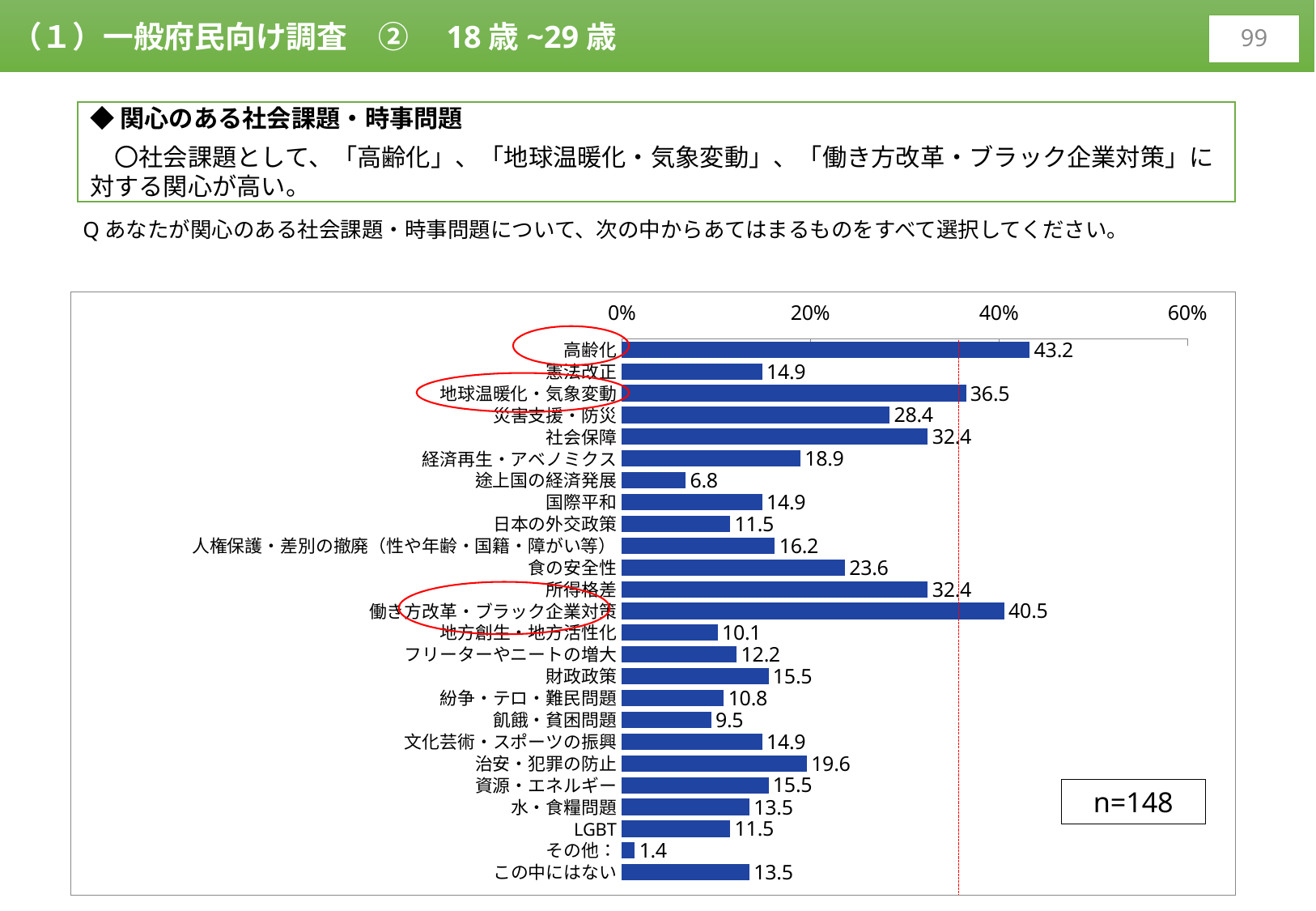
What is the value for 治安・犯罪の防止? 19.6 Is the value for 社会保障 greater or less than 20%? greater How many categories are shown in the chart? 25 What is the value for 働き方改革・ブラック企業対策? 40.5 What is the difference between the values for 高齢化 and 地球温暖化・気象変動? 6.7 Which category has the highest value? 高齢化 What is the value for 高齢化? 43.2 Which category has the lowest value? その他： What is the sample size (n) shown on the chart? n=148 What kind of chart is shown on the slide? bar chart What is the value for 途上国の経済発展? 6.8 Which is larger, the value for 災害支援・防災 or the value for 食の安全性? 災害支援・防災